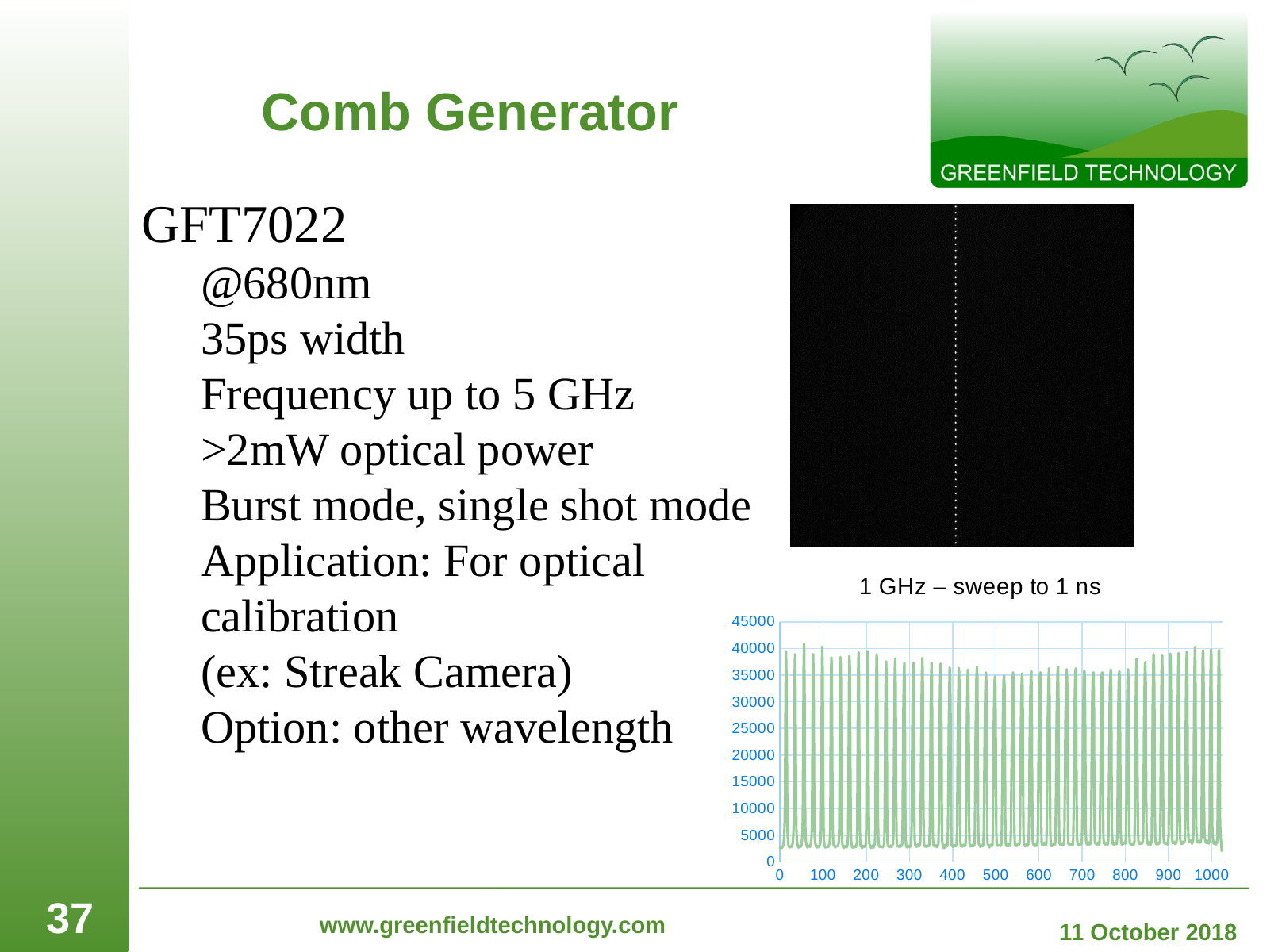
Are the peak values of the comb signal in the chart greater or less than 30000? greater Does the chart's x axis extend beyond 1000? yes Are the minimum (trough) values of the comb signal in the chart greater or less than 10000? less Are the peak values of the comb signal in the chart greater or less than 45000? less What is the title of the chart at the bottom right of the slide? 1 GHz – sweep to 1 ns What is the highest value shown on the y axis of the chart? 45000 What kind of chart is shown at the bottom right of the slide? line chart